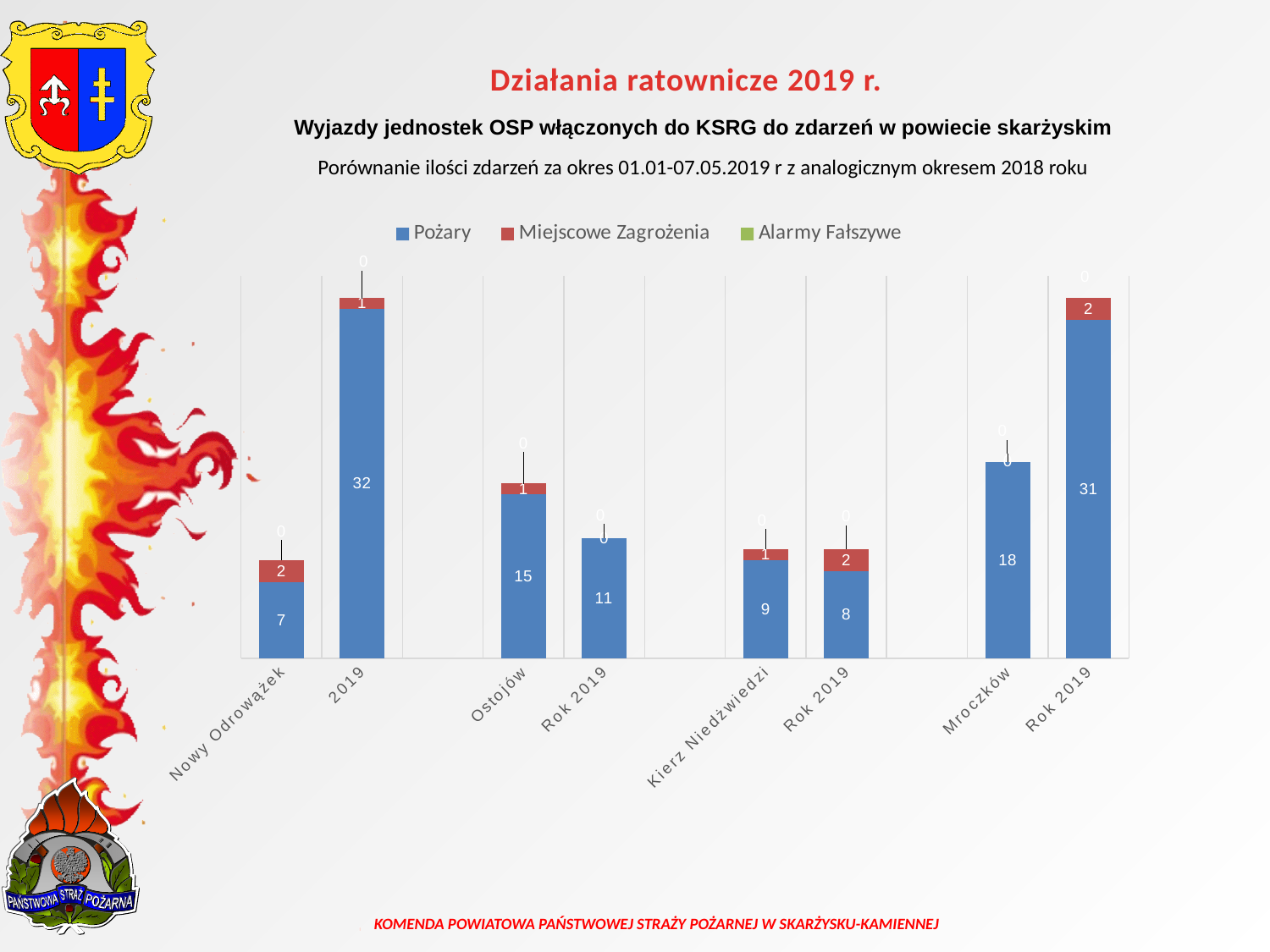
What type of chart is shown on the slide? bar chart What is the difference between the Pożary values for Mroczków and Kierz Niedźwiedzi? 9 How many series does the legend list? 3 What is the total of the stacked bar for Nowy Odrowążek? 9 Which category has the lowest Pożary value? Nowy Odrowążek What is the Miejscowe Zagrożenia value for Nowy Odrowążek? 2 What is the Pożary value for Ostojów? 15 Which category has the highest Pożary value? 2019 Which is larger, the Pożary value for Ostojów or the Pożary value for the Rok 2019 bar immediately to its right? Ostojów What is the Pożary value for Mroczków? 18 What is the Pożary value for Nowy Odrowążek? 7 What is the Miejscowe Zagrożenia value for the Rok 2019 bar immediately to the right of Mroczków? 2